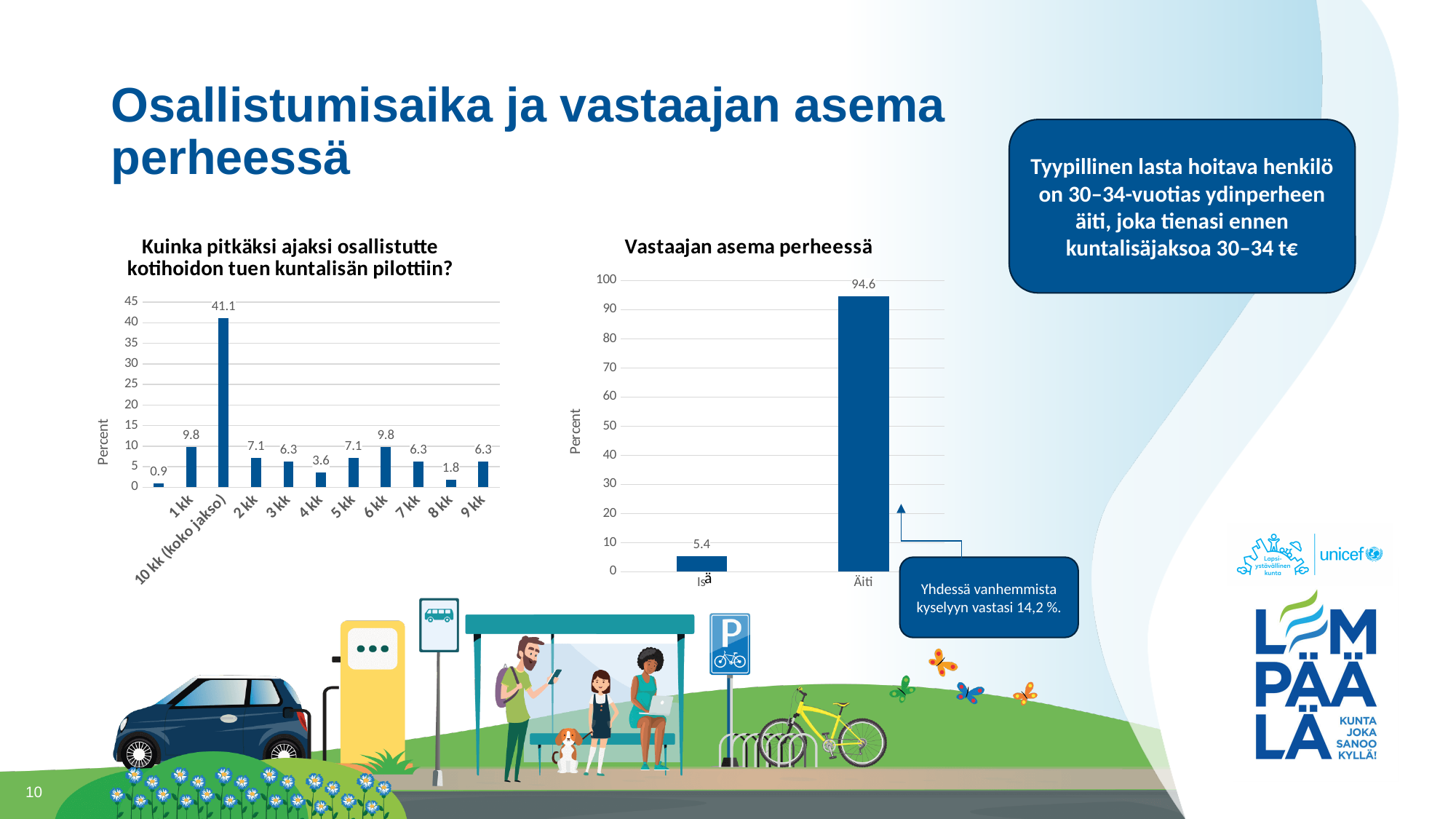
In the left chart ("Kuinka pitkäksi ajaksi osallistutte kotihoidon tuen kuntalisän pilottiin?"), what is the value for 8 kk? 1.8 What is the label on the vertical axis of the chart titled "Vastaajan asema perheessä"? Percent In the left chart ("Kuinka pitkäksi ajaksi osallistutte kotihoidon tuen kuntalisän pilottiin?"), which is larger, the value for 1 kk or the value for 4 kk? 1 kk In the chart titled "Vastaajan asema perheessä", how many categories are shown on the x axis? 2 In the left chart ("Kuinka pitkäksi ajaksi osallistutte kotihoidon tuen kuntalisän pilottiin?"), what is the value for 6 kk? 9.8 In the chart titled "Vastaajan asema perheessä", what is the difference between the values for Äiti and Isä? 89.2 What kind of chart is the chart titled "Vastaajan asema perheessä"? Bar chart In the left chart ("Kuinka pitkäksi ajaksi osallistutte kotihoidon tuen kuntalisän pilottiin?"), which category has the highest value? 10 kk (koko jakso) In the left chart ("Kuinka pitkäksi ajaksi osallistutte kotihoidon tuen kuntalisän pilottiin?"), what is the value for 10 kk (koko jakso)? 41.1 In the chart titled "Vastaajan asema perheessä", what is the value for Isä? 5.4 In the chart titled "Vastaajan asema perheessä", what is the value for Äiti? 94.6 In the left chart ("Kuinka pitkäksi ajaksi osallistutte kotihoidon tuen kuntalisän pilottiin?"), what is the difference between the values for 10 kk (koko jakso) and 1 kk? 31.3